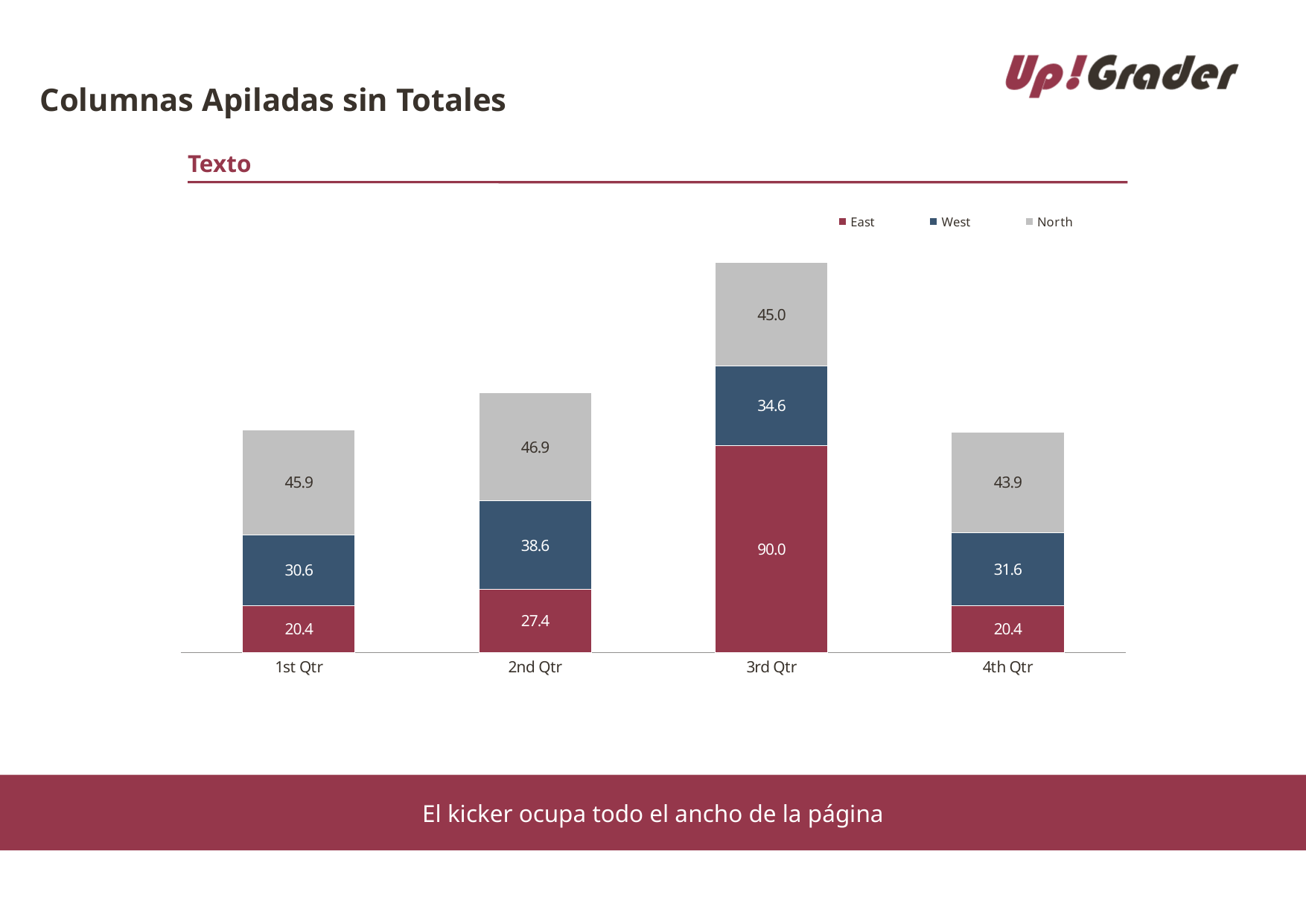
What is the East value for 3rd Qtr? 90.0 How many quarters are shown on the x axis? 4 What is the total of the stacked bar for 1st Qtr? 96.9 Which quarter has the highest East value? 3rd Qtr What is the North value for 2nd Qtr? 46.9 What is the total of the stacked bar for 3rd Qtr? 169.6 What kind of chart is shown on the slide? Stacked bar chart Which quarter has the lowest North value? 4th Qtr What is the West value for 4th Qtr? 31.6 How many series does the legend list? 3 What is the difference between the West values for 2nd Qtr and 1st Qtr? 8.0 Which is larger, the North value for 1st Qtr or the North value for 3rd Qtr? 1st Qtr